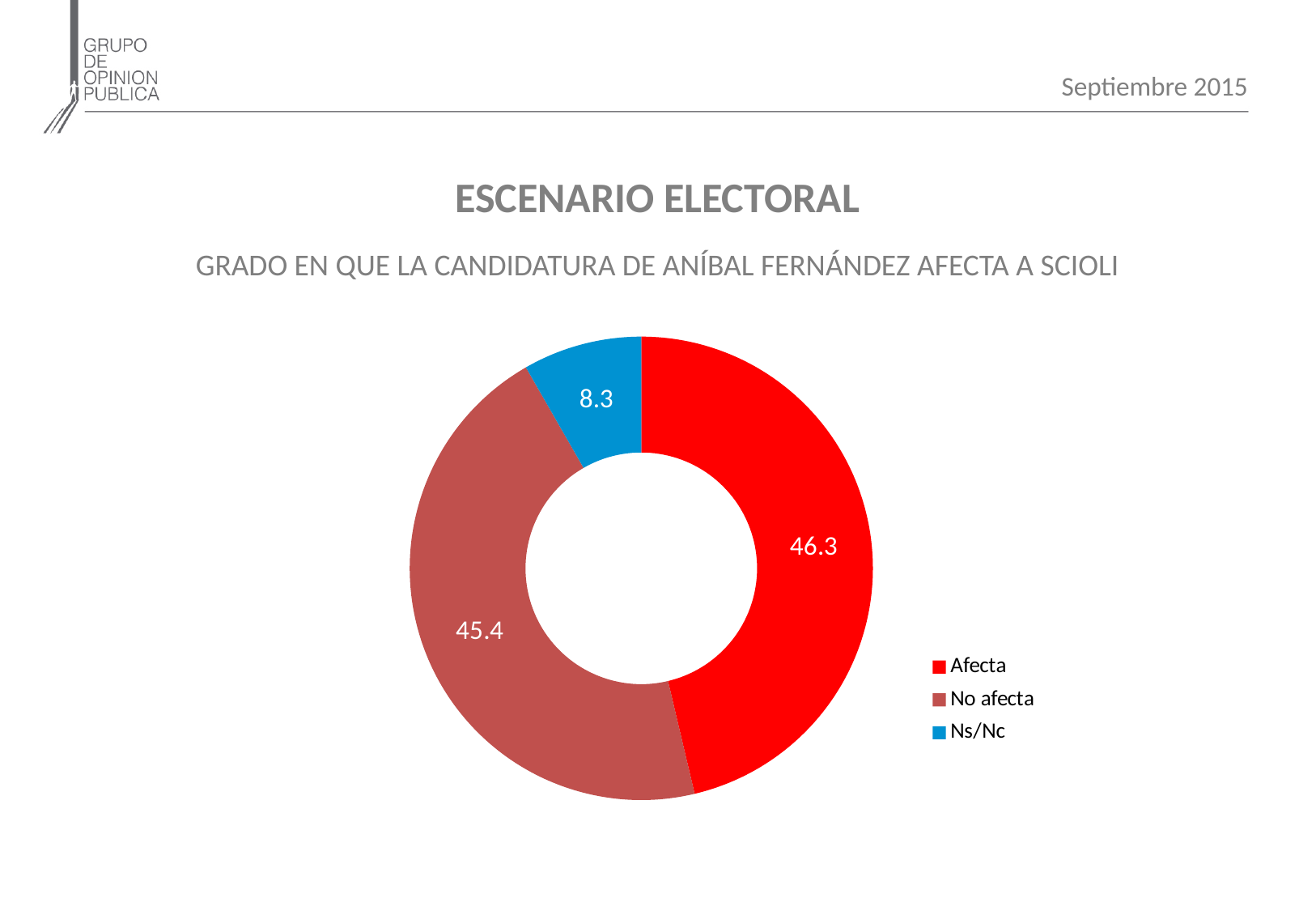
Which category has the smallest slice? Ns/Nc What is the difference between the Afecta and No afecta values? 0.9 What value is shown for the Ns/Nc slice? 8.3 How many entries does the legend list? 3 What value is shown for the Afecta slice? 46.3 What is the difference between the No afecta and Ns/Nc values? 37.1 What colour is used for the Ns/Nc slice? blue Which is larger, the value for No afecta or the value for Ns/Nc? No afecta What value is shown for the No afecta slice? 45.4 What kind of chart is shown on the slide? doughnut chart How many categories does the chart show? 3 Which category has the largest slice? Afecta